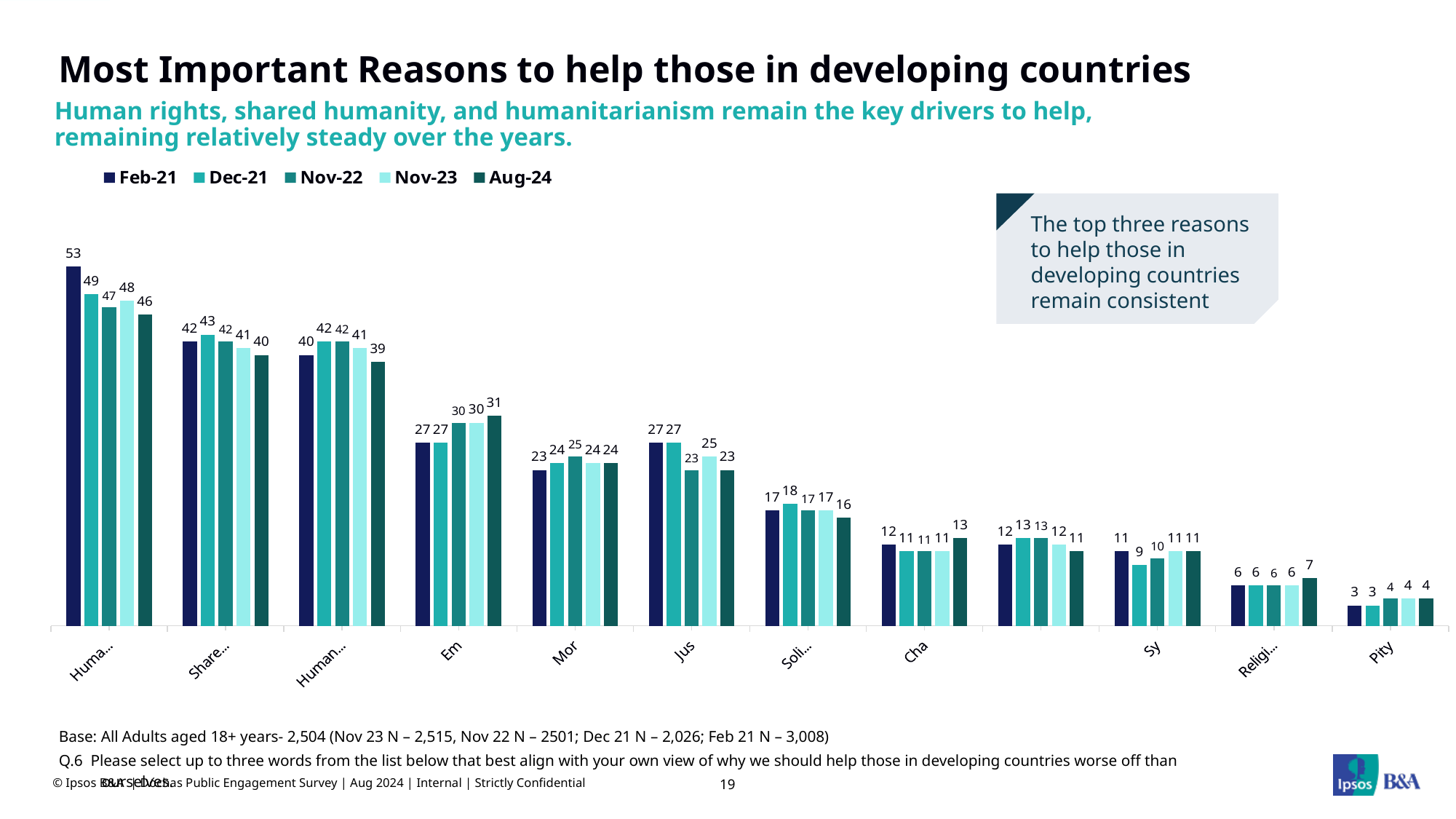
What is the Aug-24 value for Pity? 4 What is the Feb-21 value for Pity? 3 What is the highest value shown anywhere on the chart? 53 For Pity, which is larger: the Feb-21 value or the Aug-24 value? Aug-24 Do the values for Pity rise or fall from Feb-21 to Aug-24? rise What is the lowest value shown anywhere on the chart? 3 What is the difference between the Aug-24 and Feb-21 values for Pity? 1 How many categories are plotted along the x axis? 12 What kind of chart is shown on the slide? bar chart What is the Nov-22 value for Pity? 4 Which series is listed first in the legend? Feb-21 How many series does the legend list? 5